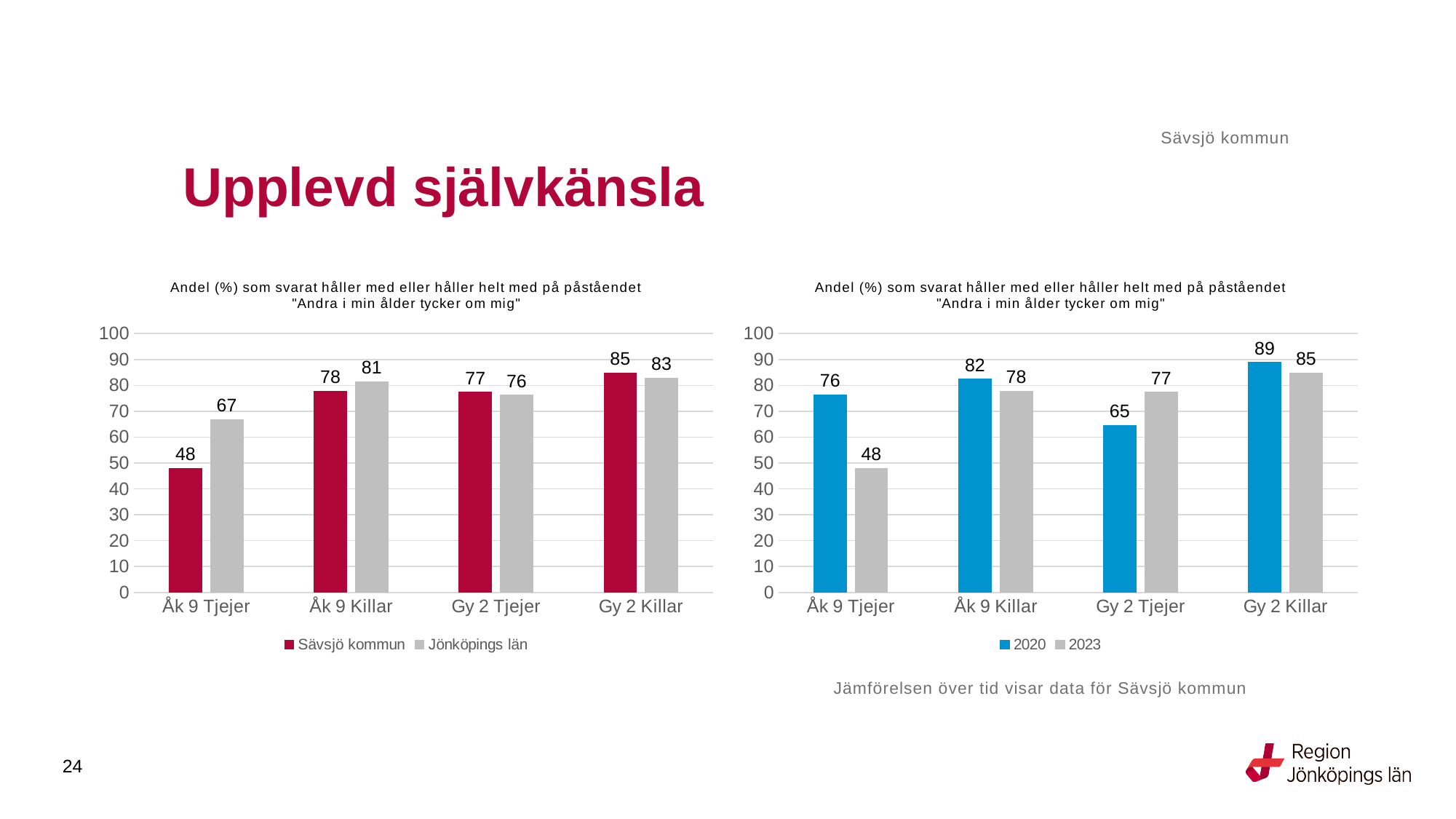
In the right chart, what is the difference between the 2020 and 2023 values for Åk 9 Tjejer? 28 In the right chart, what is the 2023 value for Gy 2 Tjejer? 77 In the right chart, which category has the highest 2020 value? Gy 2 Killar How many series does the legend of the right chart list? 2 How many categories are shown on the x axis of the left chart? 4 In the left chart, what is the value for Jönköpings län for Gy 2 Killar? 83 What type of chart is the left chart? bar chart In the left chart, which category has the lowest Sävsjö kommun value? Åk 9 Tjejer In the right chart, which is larger for Gy 2 Tjejer, the 2020 value or the 2023 value? 2023 In the left chart, what is the difference between the Jönköpings län and Sävsjö kommun values for Åk 9 Tjejer? 19 What are the two series listed in the legend of the left chart? Sävsjö kommun and Jönköpings län In the left chart, what is the value for Sävsjö kommun for Åk 9 Tjejer? 48